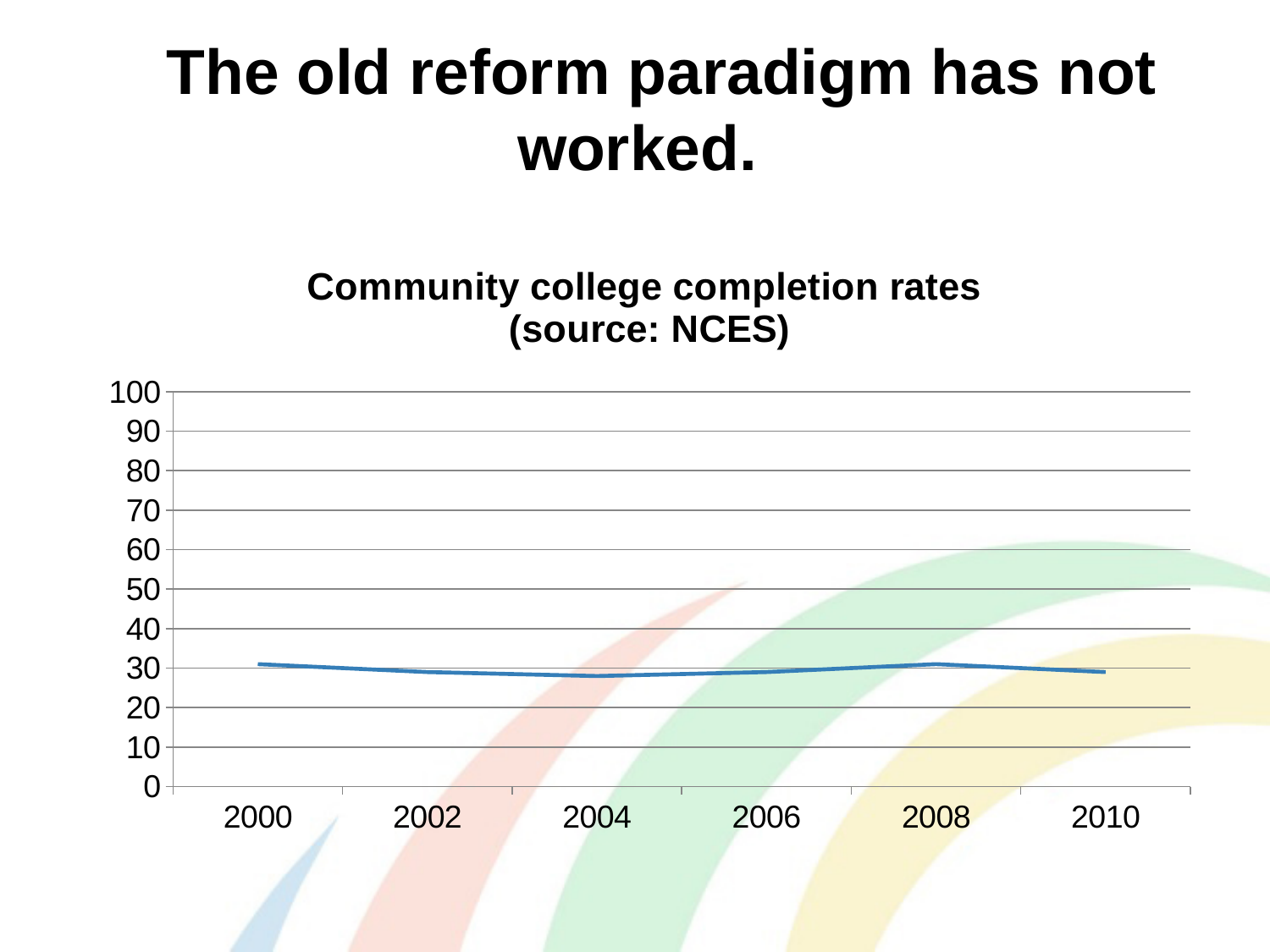
Is the value for 2010 greater or less than 20? greater Is the value for 2008 greater or less than 50? less Which is larger, the value for 2000 or the value for 2004? 2000 Do the completion rates rise sharply, fall sharply, or stay roughly flat from 2000 to 2010? stay roughly flat Is the value for 2004 greater or less than 20? greater What is the title of the chart? Community college completion rates (source: NCES) What is the highest value shown on the y axis of the chart? 100 What kind of chart is shown on the slide? line chart How many years are plotted on the x axis of the chart? 6 Which is larger, the value for 2008 or the value for 2004? 2008